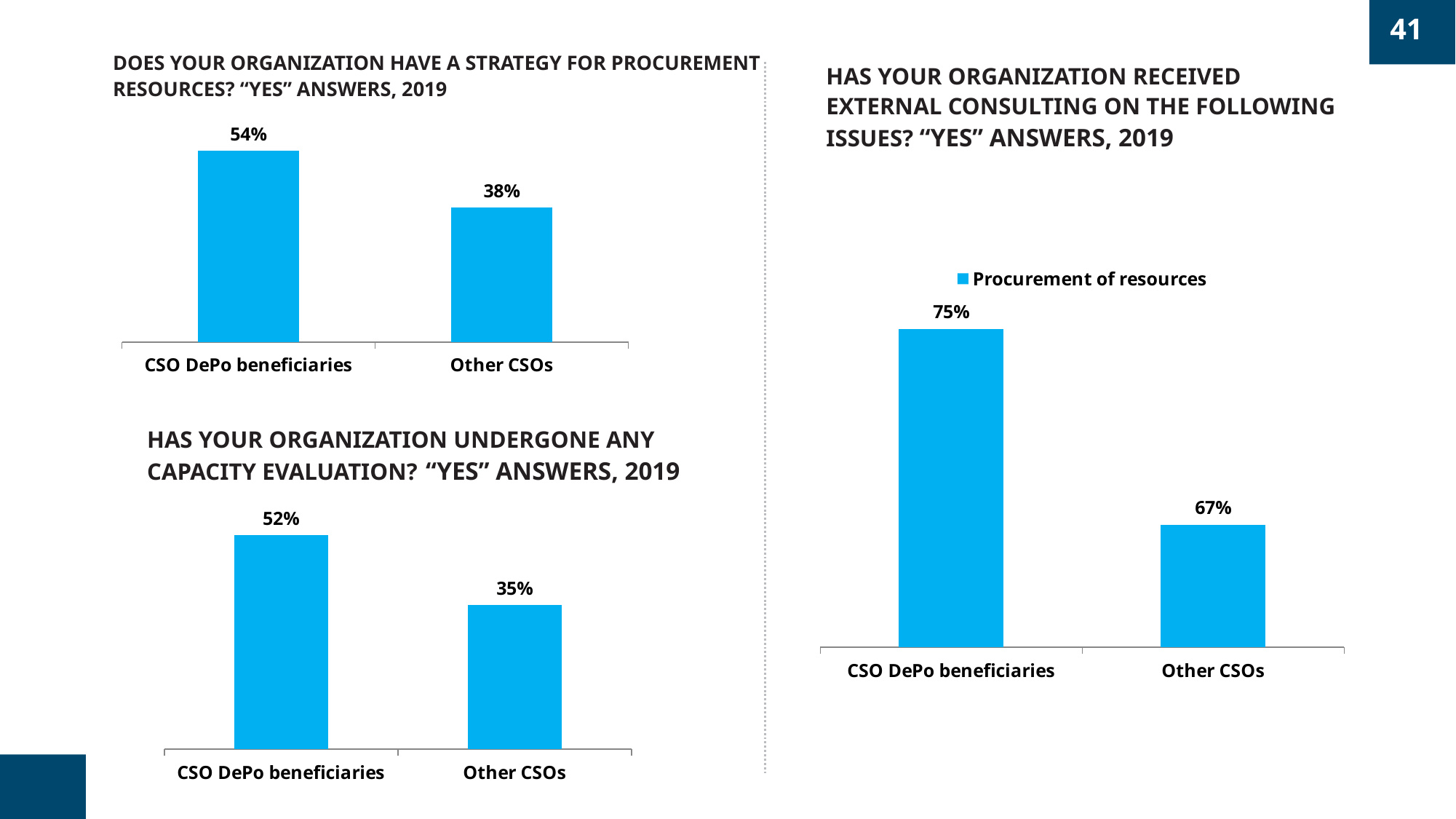
In the bottom-left chart on capacity evaluation, what is the value for CSO DePo beneficiaries? 52% In the top-left chart on procurement resources strategy, what is the value for Other CSOs? 38% In the right-hand chart on external consulting, what is the value for CSO DePo beneficiaries? 75% In the right-hand chart on external consulting, what series does the legend list? Procurement of resources What kind of chart is the right-hand chart on external consulting? Bar chart In the right-hand chart on external consulting, what is the difference between CSO DePo beneficiaries and Other CSOs? 8% In the top-left chart on procurement resources strategy, what is the value for CSO DePo beneficiaries? 54% In the top-left chart on procurement resources strategy, what is the difference between CSO DePo beneficiaries and Other CSOs? 16% In the bottom-left chart on capacity evaluation, what is the value for Other CSOs? 35% In the right-hand chart on external consulting, what is the value for Other CSOs? 67% In the bottom-left chart on capacity evaluation, which category has the lowest value? Other CSOs In the right-hand chart on external consulting, which category has the highest value? CSO DePo beneficiaries